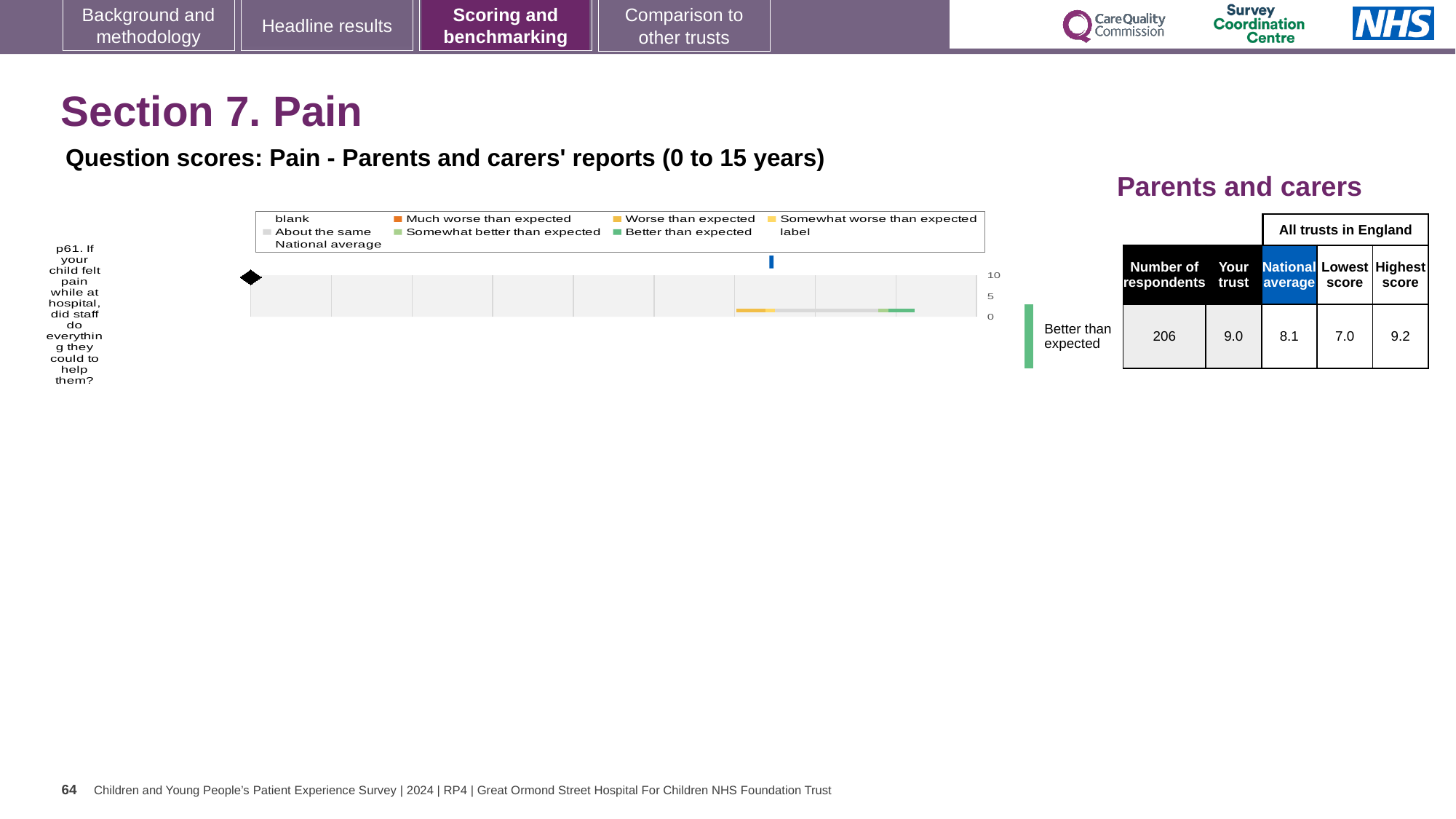
How many respondents answered question p61? 206 What kind of chart is used to show the score for question p61? bar chart What is the highest score among all trusts in England for question p61? 9.2 What is the highest value shown on the chart's score axis? 10 What is the lowest score among all trusts in England for question p61? 7.0 Which is larger for question p61: the 'Your trust' score or the national average? Your trust Is the 'Your trust' score for question p61 greater or less than 5 on the chart's axis? greater Which benchmarking category is question p61 (pain) rated as for parents and carers? Better than expected What is the difference between the 'Your trust' score and the national average for question p61? 0.9 What is the 'Your trust' score for question p61 about staff helping with pain? 9.0 What is the national average score for question p61? 8.1 How many survey questions are plotted in the chart? 1